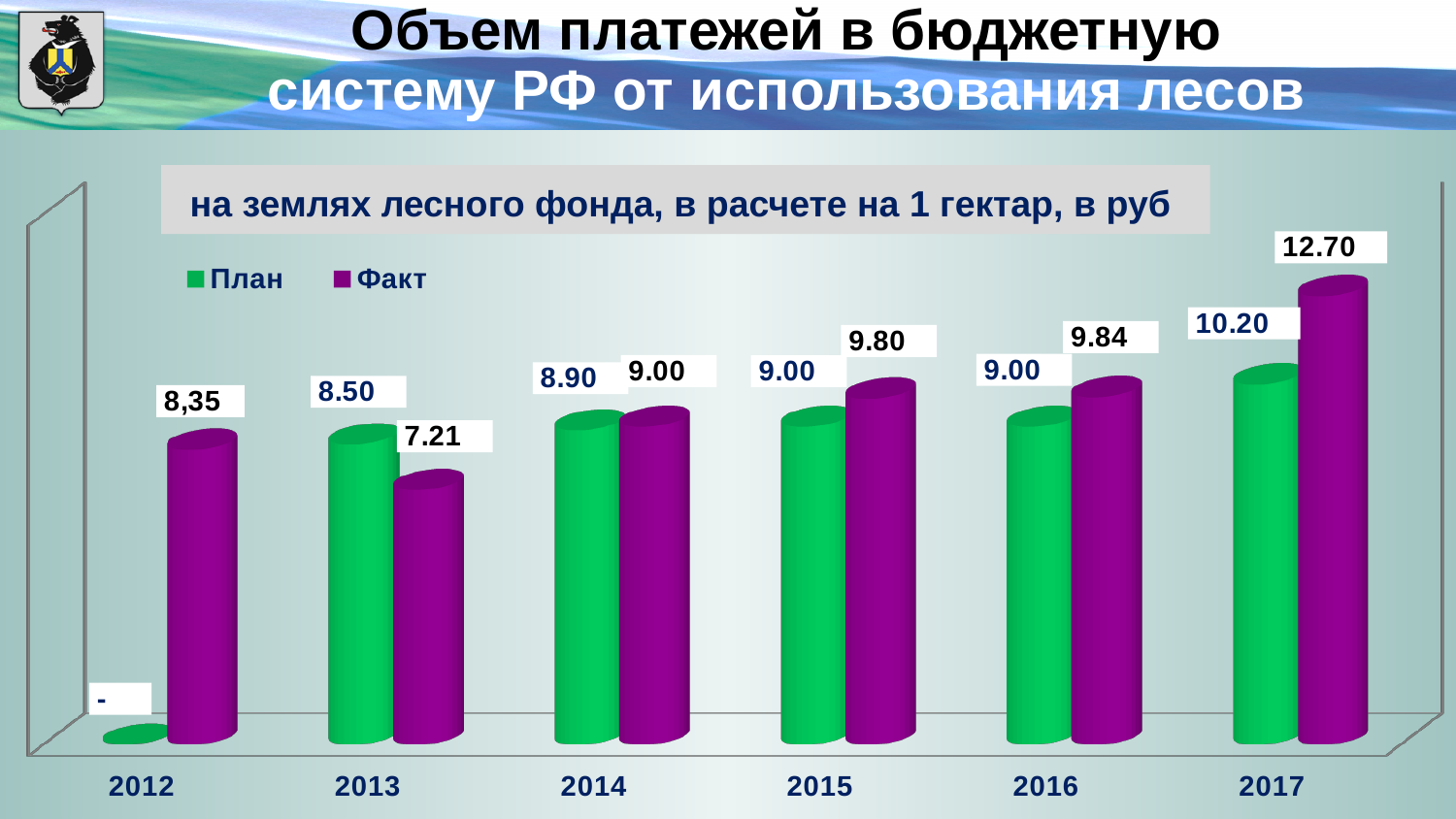
What is the Факт value for 2017? 12.70 Which year has the highest Факт value? 2017 How many series does the legend list? 2 Which is larger for 2013, the План value or the Факт value? План What is the difference between the Факт and План values for 2017? 2.50 What kind of chart is shown on the slide? bar chart Which year has the lowest Факт value? 2013 How many years are shown on the x axis? 6 Do the Факт values rise or fall from 2013 to 2017? rise What is the План value for 2013? 8.50 What is the План value for 2014? 8.90 What is the Факт value for 2012? 8,35